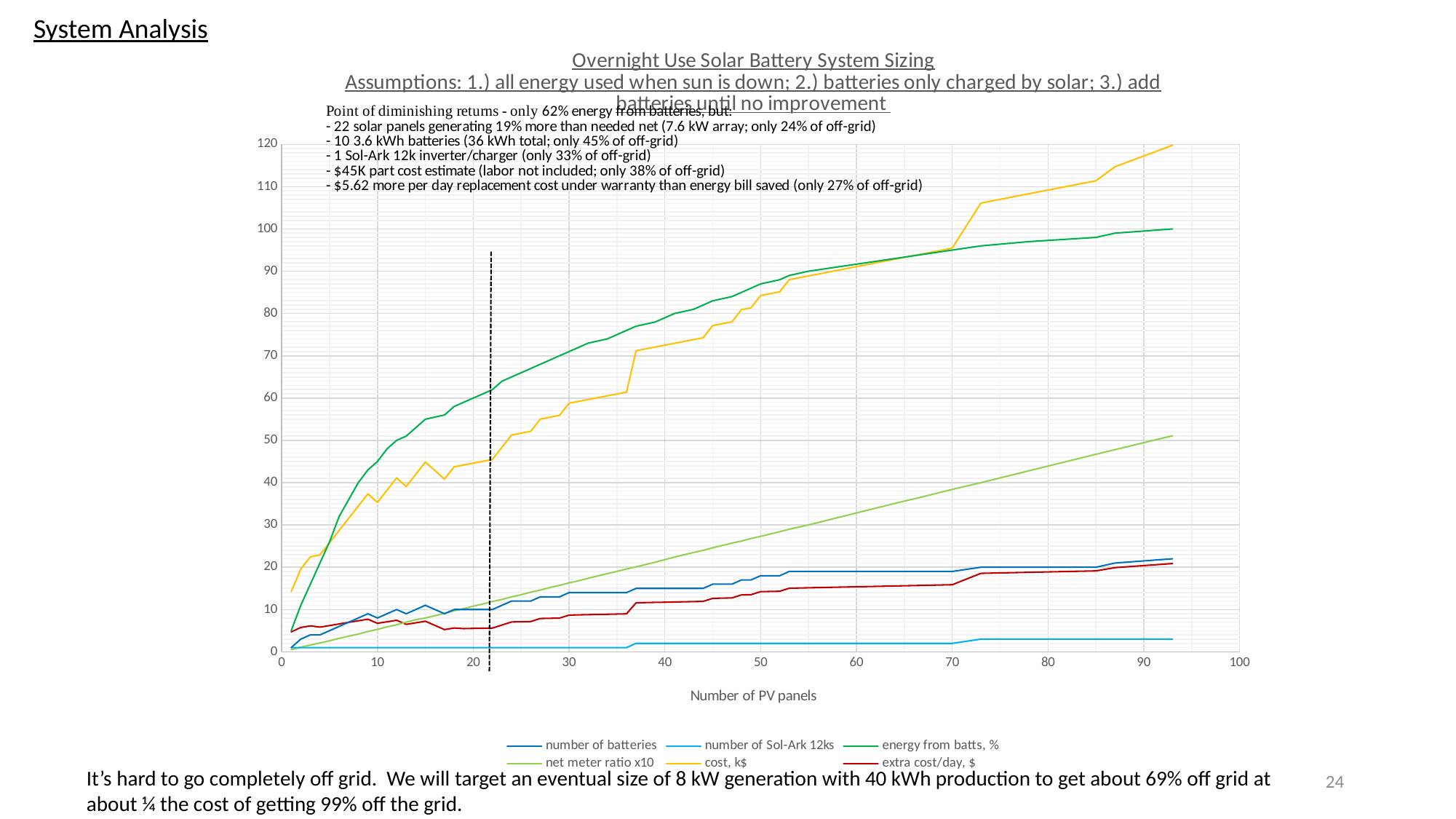
What is the label of the x axis? Number of PV panels What kind of chart is shown on the slide? line chart Is the value of 'cost, k$' at 90 PV panels greater or less than 110? greater Is the value of 'extra cost/day, $' at 50 PV panels greater or less than 20? less At 20 PV panels, which is higher: 'energy from batts, %' or 'cost, k$'? energy from batts, % How many series does the legend list? 6 Which series stays lowest across the whole chart? number of Sol-Ark 12ks What is the first line of the chart title? Overnight Use Solar Battery System Sizing Is the value of 'energy from batts, %' at 50 PV panels greater or less than 80? greater Does the 'cost, k$' series rise or fall as the number of PV panels increases? rise At 80 PV panels, which is higher: 'cost, k$' or 'energy from batts, %'? cost, k$ Which series reaches the highest value at the right end of the chart? cost, k$